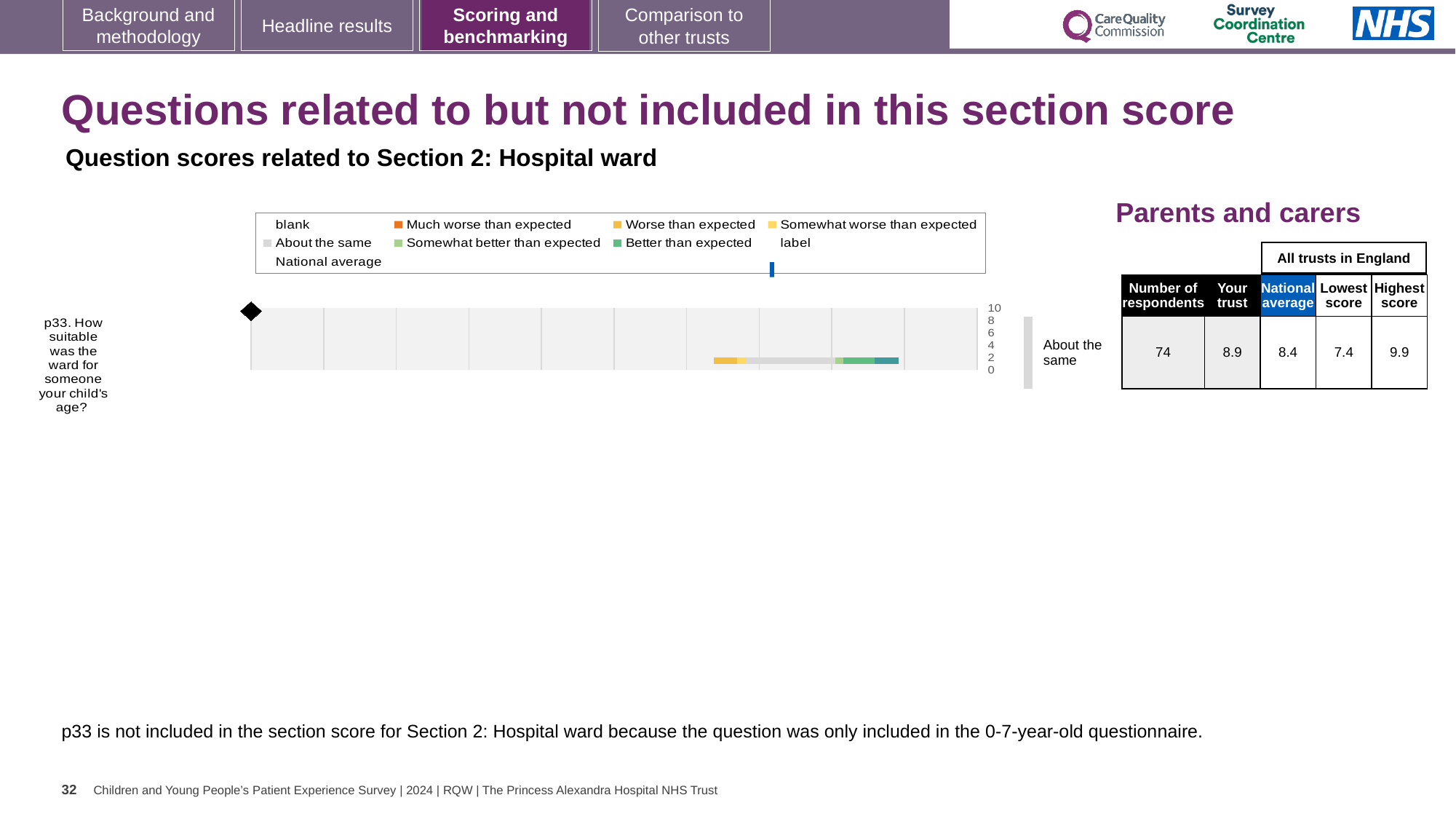
In the table beside the chart, what is the national average score for p33? 8.4 Is the 'Your trust' score for p33 higher or lower than the national average? higher In the table beside the chart, what is the 'Your trust' score for p33? 8.9 In the table beside the chart, what is the highest score among all trusts in England for p33? 9.9 How many questions (categories) are plotted in the chart? 1 What kind of chart is shown for question p33? bar chart In the table beside the chart, what is the lowest score among all trusts in England for p33? 7.4 What is the difference between the highest score and the lowest score for p33 in the table? 2.5 What benchmark rating is shown next to the chart for question p33? About the same What is the highest tick value shown on the chart's axis? 10 How many entries does the chart legend list? 9 In the table beside the chart, how many respondents answered p33? 74